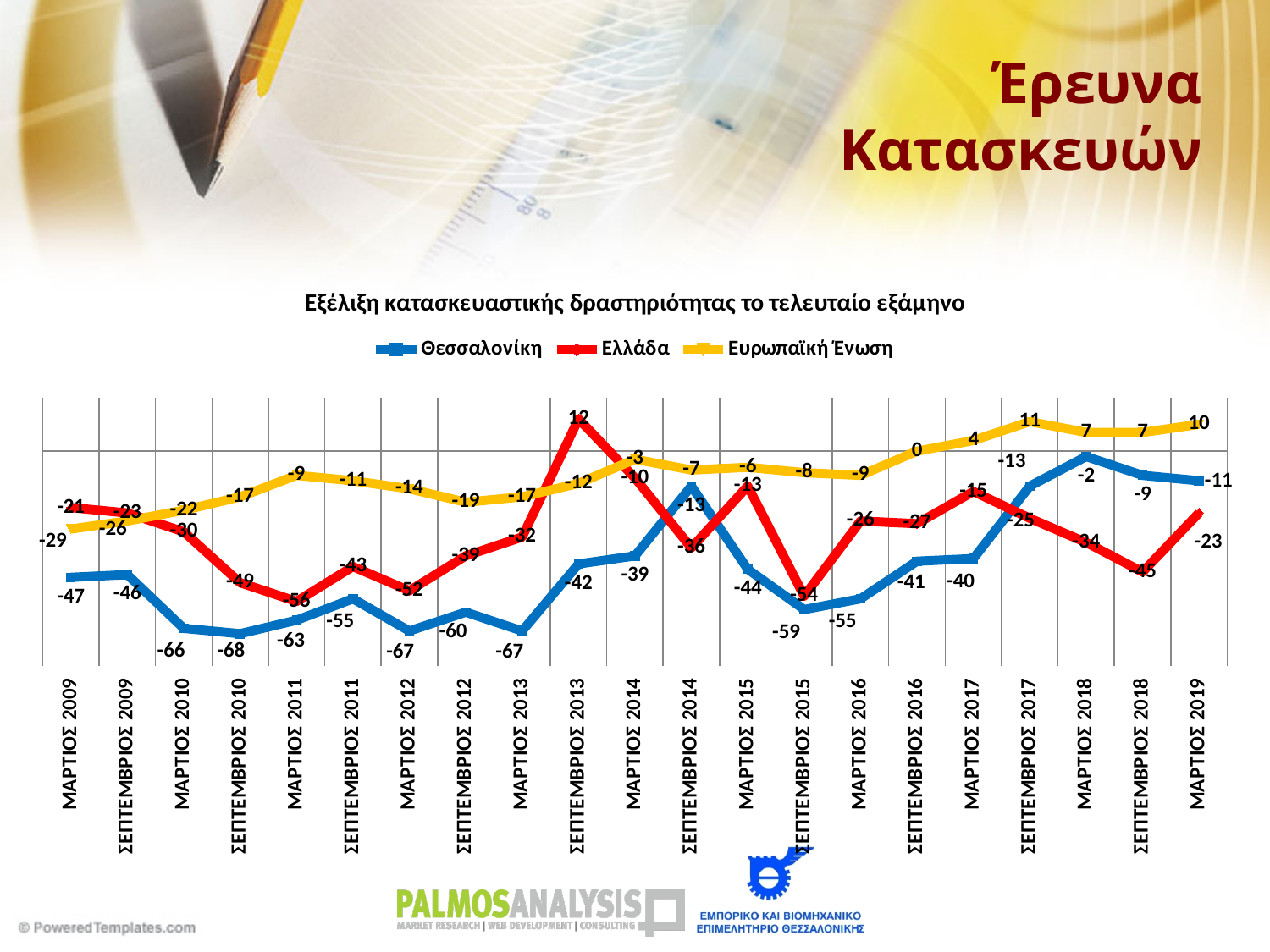
What colour is the line for Ευρωπαϊκή Ένωση? Yellow What is the difference between the Ελλάδα value and the Θεσσαλονίκη value in ΜΑΡΤΙΟΣ 2009? 26 What is the value for Θεσσαλονίκη in ΜΑΡΤΙΟΣ 2019? -11 What kind of chart is shown on the slide? Line chart What is the value for Ελλάδα in ΜΑΡΤΙΟΣ 2019? -23 In ΜΑΡΤΙΟΣ 2018, which series has the higher value, Θεσσαλονίκη or Ελλάδα? Θεσσαλονίκη At which time point does Θεσσαλονίκη reach its lowest value? ΣΕΠΤΕΜΒΡΙΟΣ 2010 How many series does the legend list? 3 What is the value for Ευρωπαϊκή Ένωση in ΣΕΠΤΕΜΒΡΙΟΣ 2017? 11 At which time point does Ελλάδα reach its highest value? ΣΕΠΤΕΜΒΡΙΟΣ 2013 What is the value for Ελλάδα in ΣΕΠΤΕΜΒΡΙΟΣ 2013? 12 How many time points are plotted along the x axis? 21